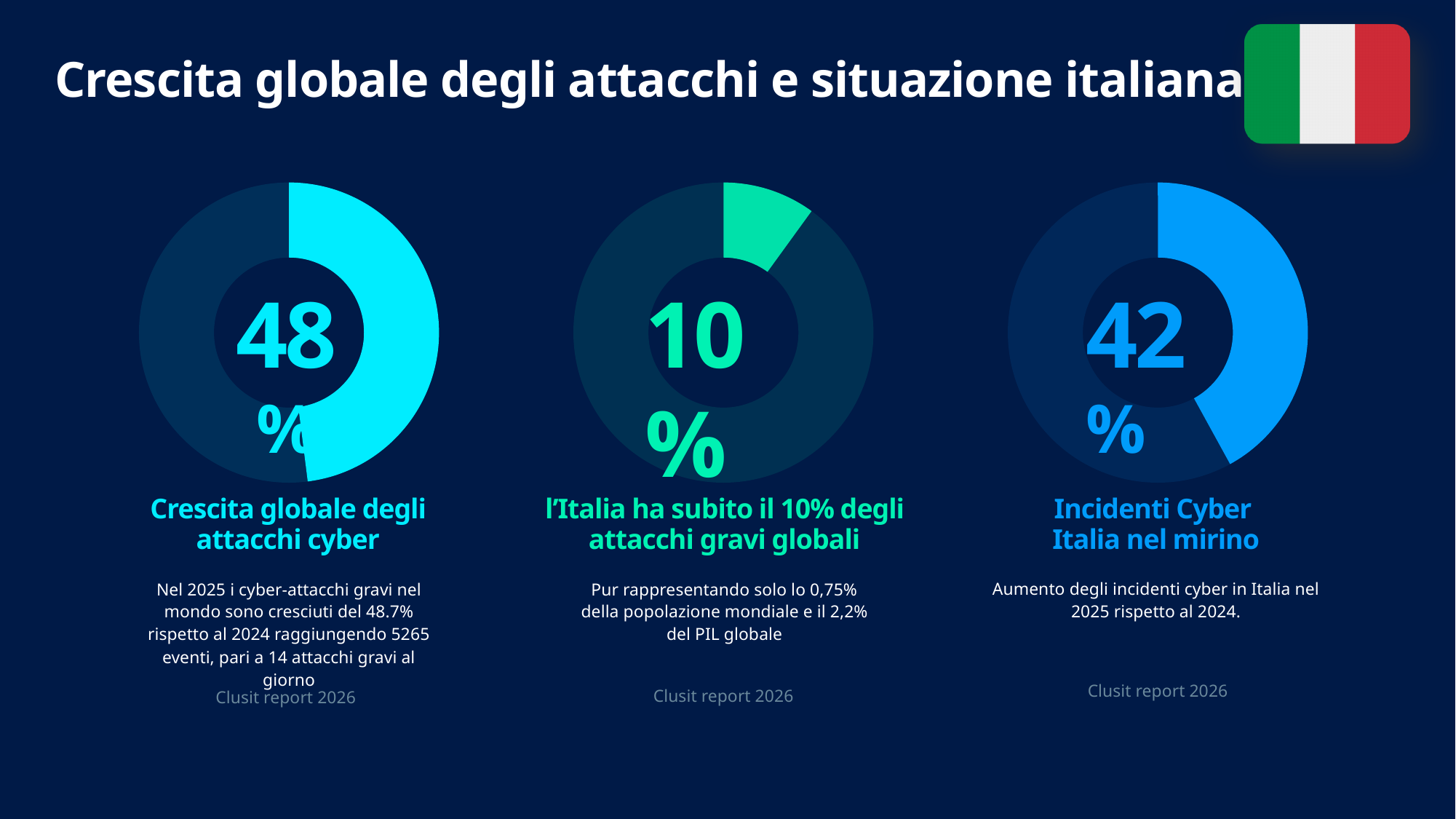
Which of the three donut charts shows the highest percentage? Crescita globale degli attacchi cyber (48%) What colour is the filled segment of the middle donut chart showing 10%? Green What source is cited beneath each of the three donut charts? Clusit report 2026 What kind of chart is used for each of the three figures on the slide? Donut chart What is the difference between the left donut chart value (48%) and the right donut chart value (42%)? 6% What is the difference between the left donut chart value (48%) and the middle donut chart value (10%)? 38% Is the value in the left donut chart (48%) larger or smaller than the value in the right donut chart (42%)? Larger What value is shown in the centre of the left donut chart titled "Crescita globale degli attacchi cyber"? 48% What value is shown in the centre of the middle donut chart about Italy's share of serious global attacks? 10% Which of the three donut charts shows the lowest percentage? l'Italia ha subito il 10% degli attacchi gravi globali (10%) What value is shown in the centre of the right donut chart titled "Incidenti Cyber Italia nel mirino"? 42% How many donut charts are shown on the slide? 3